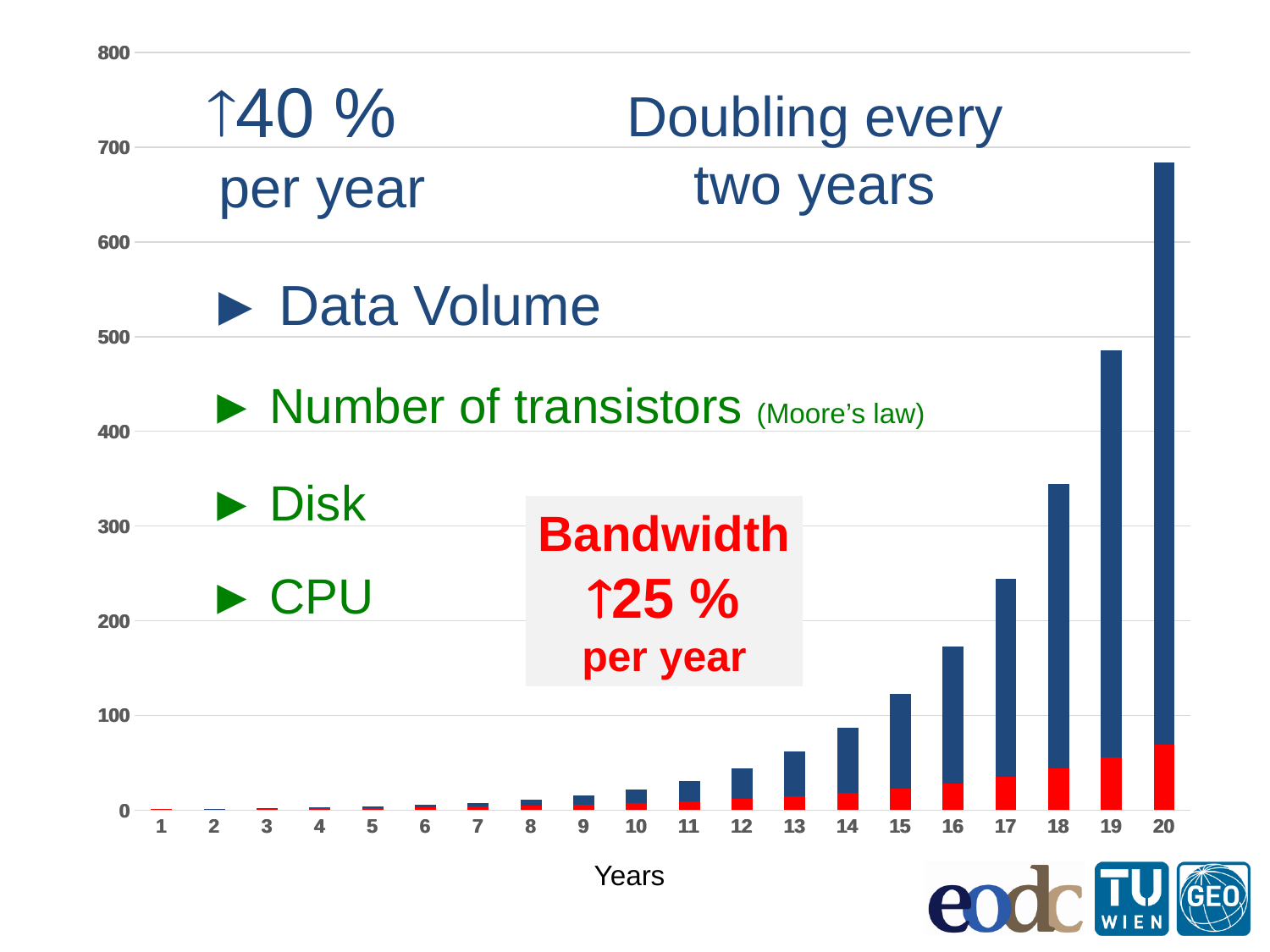
Is the blue bar for year 14 greater or less than 100? less What kind of chart is shown on the slide? bar chart Is the blue bar for year 20 greater or less than 700? less How many years are shown along the x axis of the chart? 20 Is the red bar for year 20 greater or less than 100? less What is the title of the x axis? Years Which is larger, the blue bar for year 19 or the blue bar for year 20? year 20 Which year has the tallest blue bar? 20 Do the blue bars rise or fall as the years increase from 1 to 20? rise